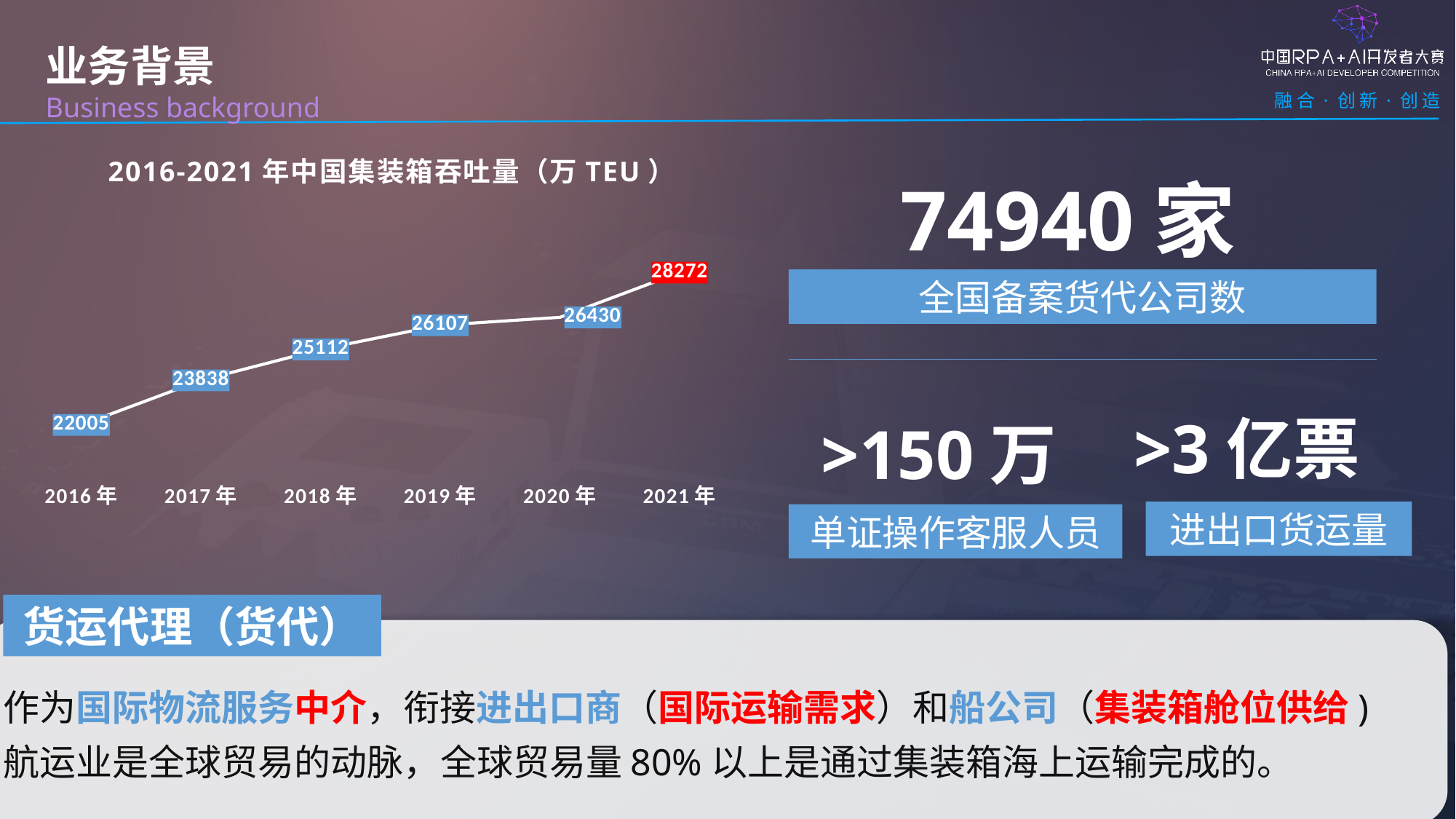
What is the title of the chart on the slide? 2016-2021年中国集装箱吞吐量（万TEU） What kind of chart is shown on the slide? Line chart Which year has the lowest container throughput in the chart? 2016年 Which is larger in the chart, the value for 2018年 or the value for 2019年? 2019年 Which year has the highest container throughput in the chart? 2021年 What is the container throughput value for 2021年 in the chart? 28272 What is the container throughput value for 2019年 in the chart? 26107 What is the difference between the 2018年 and 2017年 values in the chart? 1274 What is the container throughput value for 2016年 in the chart? 22005 How many years are plotted in the chart? 6 Do the values in the chart rise or fall from 2016年 to 2021年? Rise What is the difference between the 2021年 and 2020年 values in the chart? 1842